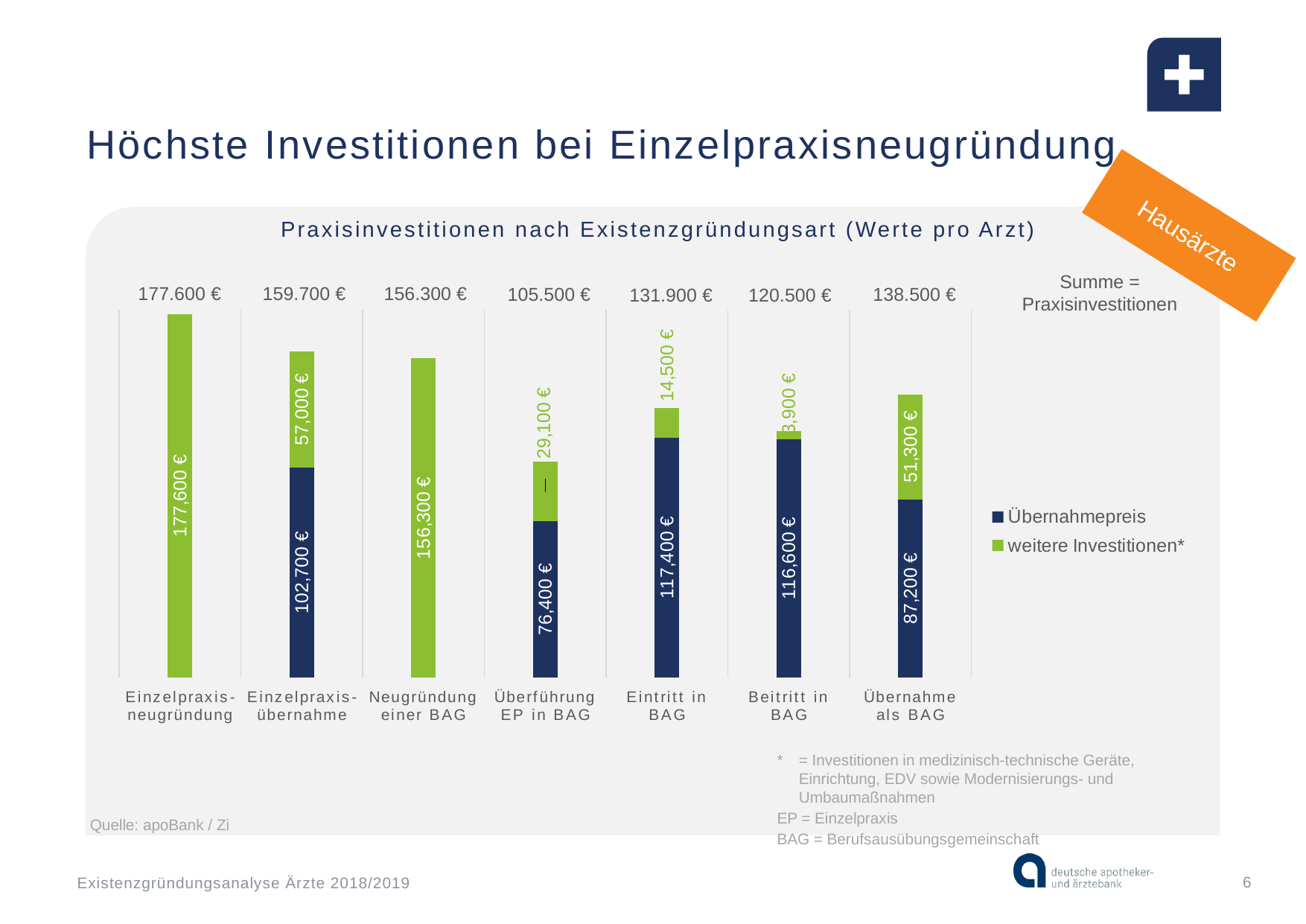
Which is larger: the weitere Investitionen* for Einzelpraxisübernahme or for Übernahme als BAG? Einzelpraxisübernahme What is the Übernahmepreis value for Einzelpraxisübernahme? 102,700 € What is the difference between the Übernahmepreis for Eintritt in BAG and for Beitritt in BAG? 800 € Which category has the lowest total Praxisinvestitionen? Überführung EP in BAG What is the title of the chart? Praxisinvestitionen nach Existenzgründungsart (Werte pro Arzt) Which category has the highest total Praxisinvestitionen? Einzelpraxisneugründung What is the total (Summe) of Praxisinvestitionen shown for Überführung EP in BAG? 105.500 € What is the weitere Investitionen* value for Übernahme als BAG? 51,300 € What is the weitere Investitionen* value for Eintritt in BAG? 14,500 € How many series does the legend list? 2 What kind of chart is shown on the slide? Stacked bar chart How many categories are shown on the x axis of the chart? 7